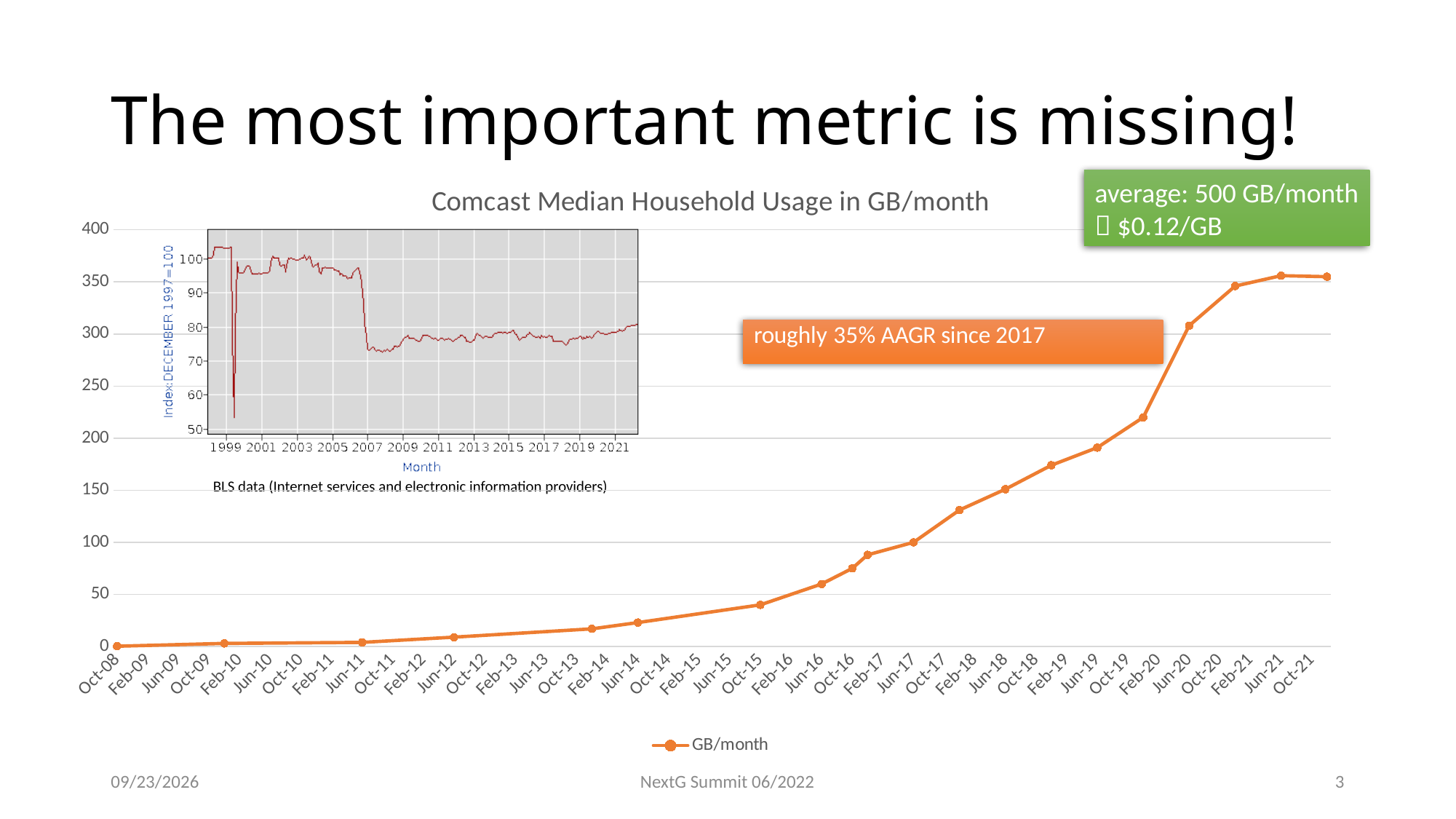
In the Comcast Median Household Usage chart, is the value for Feb-20 greater or less than 200? greater What kind of chart is the Comcast Median Household Usage chart? line chart In the Comcast Median Household Usage chart, is the value for Jun-20 greater or less than 300? greater In the Comcast Median Household Usage chart, is the value for Feb-19 greater or less than 150? greater In the Comcast Median Household Usage chart, do the values generally rise or fall from Oct-08 to Oct-21? rise What is the name of the series shown in the legend of the Comcast Median Household Usage chart? GB/month In the Comcast Median Household Usage chart, which is larger, the value for Jun-16 or the value for Feb-18? Feb-18 How many series does the legend of the Comcast Median Household Usage chart list? 1 What is the x-axis label of the inset BLS chart? Month In the Comcast Median Household Usage chart, which date has the lowest value? Oct-08